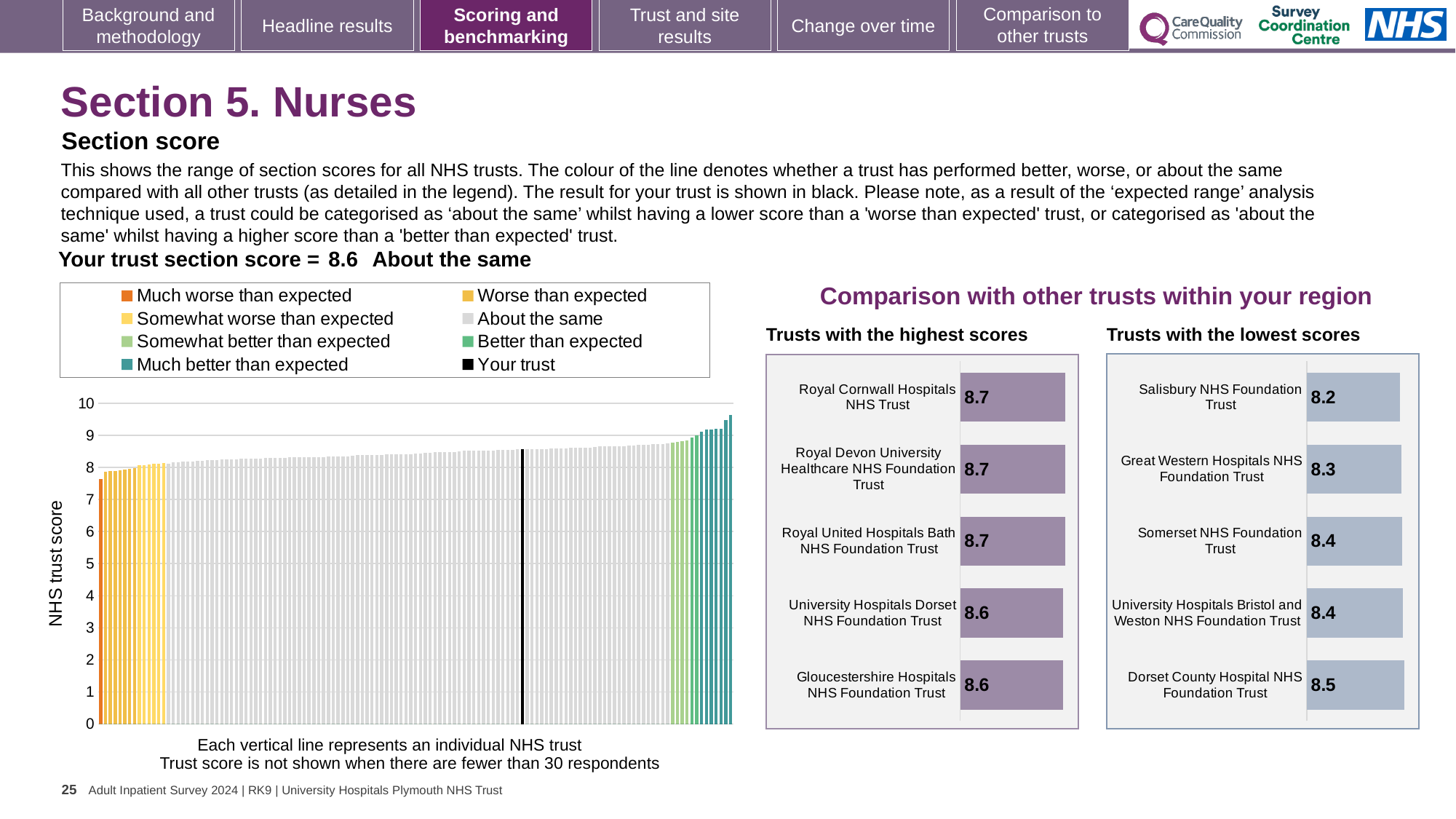
How many trusts are listed in the 'Trusts with the highest scores' chart? 5 In the 'Trusts with the highest scores' chart, what is the score for Royal Cornwall Hospitals NHS Trust? 8.7 In the 'Trusts with the lowest scores' chart, what is the difference between the scores of Dorset County Hospital NHS Foundation Trust and Salisbury NHS Foundation Trust? 0.3 In the 'Trusts with the lowest scores' chart, what is the score for Salisbury NHS Foundation Trust? 8.2 In the 'Trusts with the highest scores' chart, what is the score for Gloucestershire Hospitals NHS Foundation Trust? 8.6 In the main NHS trust score chart on the left, what is the section score for your trust? 8.6 In the main NHS trust score chart on the left, is the value of the lowest (orange) bar greater or less than 8? less In the 'Trusts with the lowest scores' chart, which has the larger score: Great Western Hospitals NHS Foundation Trust or Somerset NHS Foundation Trust? Somerset NHS Foundation Trust What kind of chart is the 'Trusts with the highest scores' chart? Bar chart In the 'Trusts with the lowest scores' chart, which trust has the lowest score? Salisbury NHS Foundation Trust How many entries does the legend of the main NHS trust score chart on the left list? 8 In the 'Trusts with the lowest scores' chart, which trust has the highest score? Dorset County Hospital NHS Foundation Trust